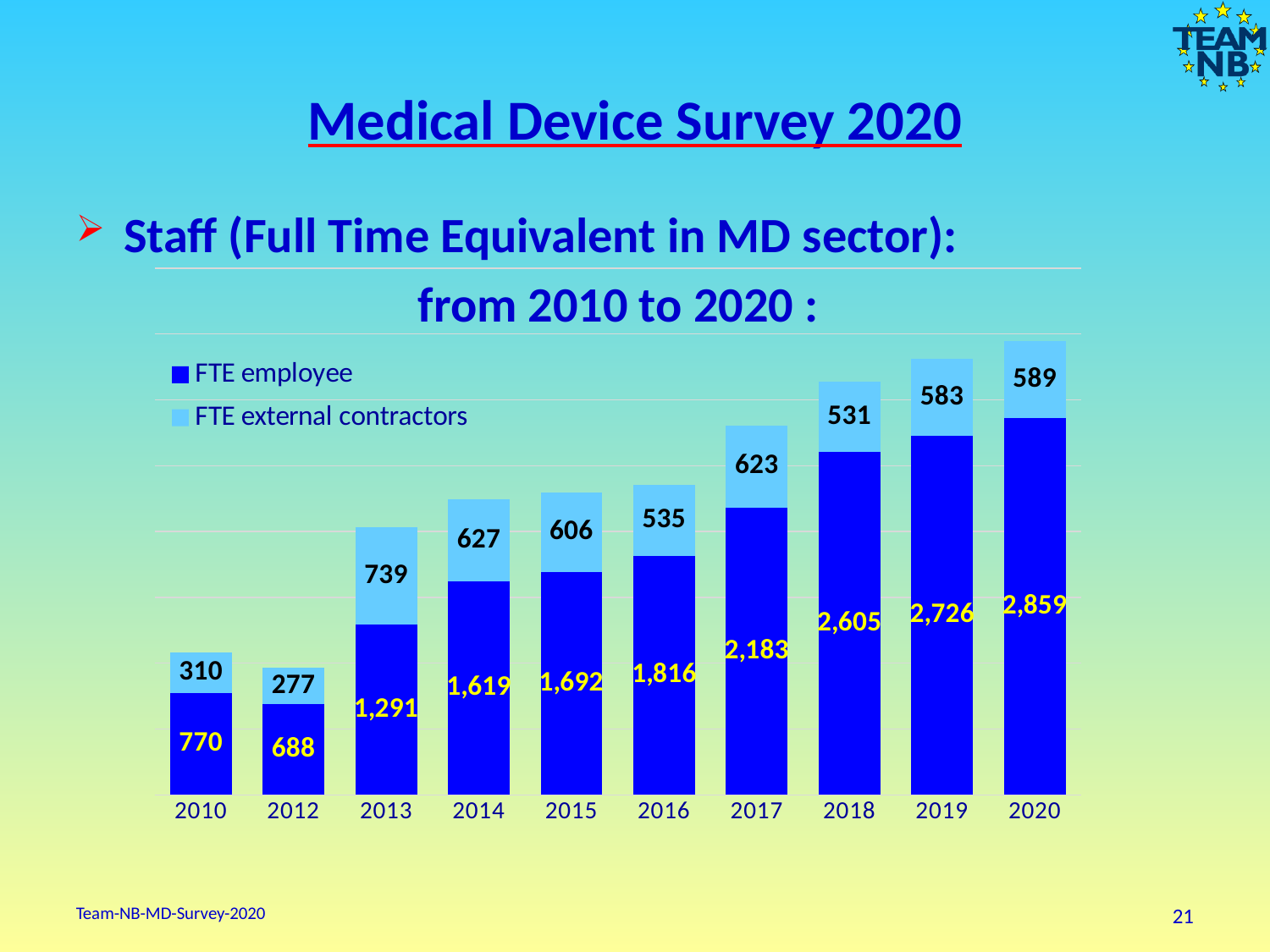
What is the FTE external contractors value for 2013? 739 Which year has the highest FTE employee value? 2020 What is the difference between the FTE employee values for 2020 and 2019? 133 Which year has the lowest FTE employee value? 2012 What is the FTE employee value for 2020? 2,859 Which is larger, the FTE external contractors value for 2017 or for 2018? 2017 Do the FTE employee values generally rise or fall from 2012 to 2020? Rise Which year has the highest FTE external contractors value? 2013 How many series does the legend list? 2 How many years are shown on the x axis? 10 What kind of chart is shown? Stacked bar chart What is the total of the stacked bar for 2020? 3,448